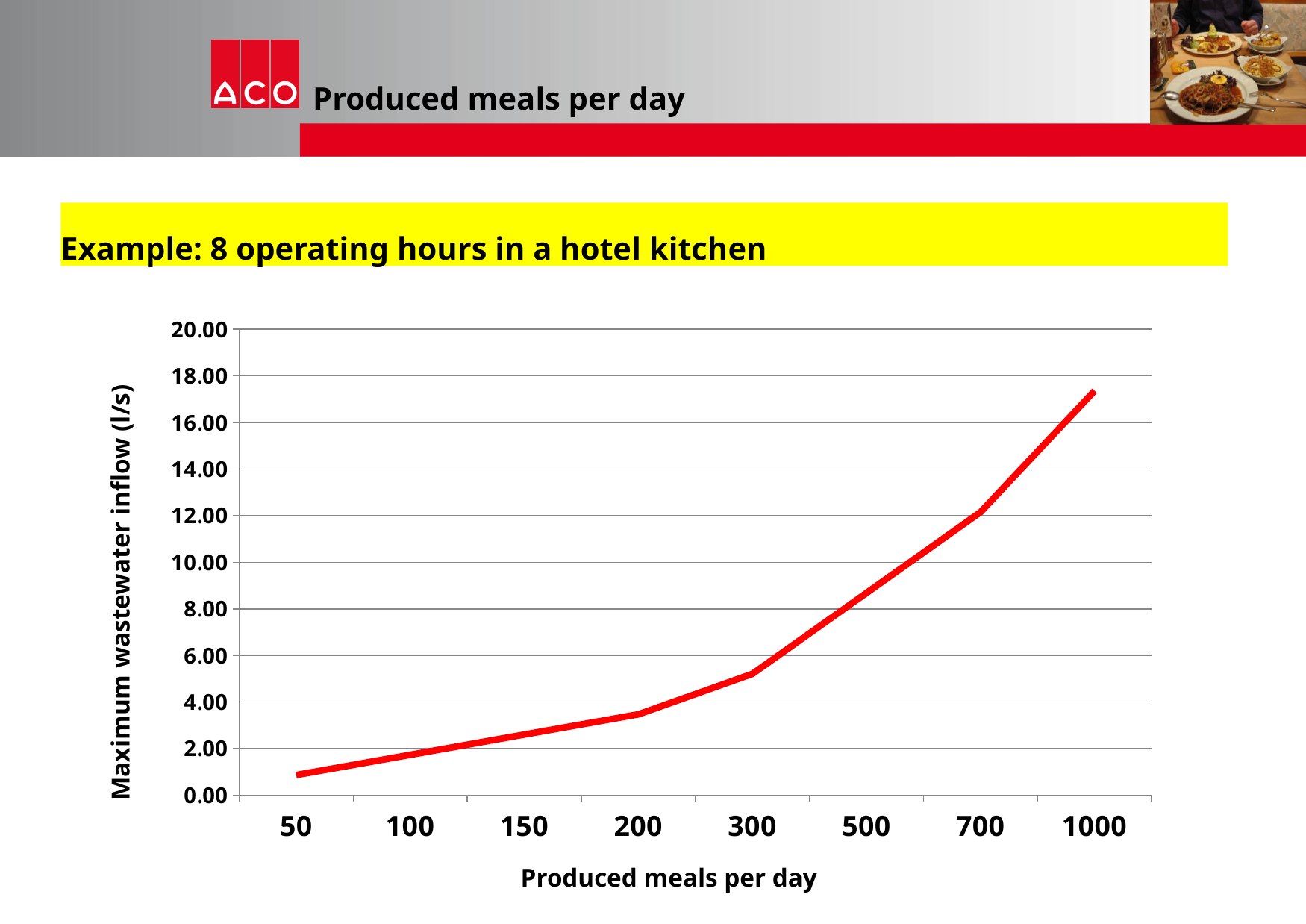
What kind of chart is shown on the slide? line chart Do the values rise or fall as produced meals per day increase along the x axis? rise Is the maximum wastewater inflow for 1000 meals per day greater or less than 16.00? greater Which produced-meals-per-day category has the lowest maximum wastewater inflow? 50 How many data points (meals-per-day categories) are plotted on the x axis? 8 Is the maximum wastewater inflow for 500 meals per day greater or less than 10.00? less Which has a larger maximum wastewater inflow: 200 meals per day or 700 meals per day? 700 Is the maximum wastewater inflow for 50 meals per day greater or less than 2.00? less What is the label of the y axis? Maximum wastewater inflow (l/s) Which produced-meals-per-day category has the highest maximum wastewater inflow? 1000